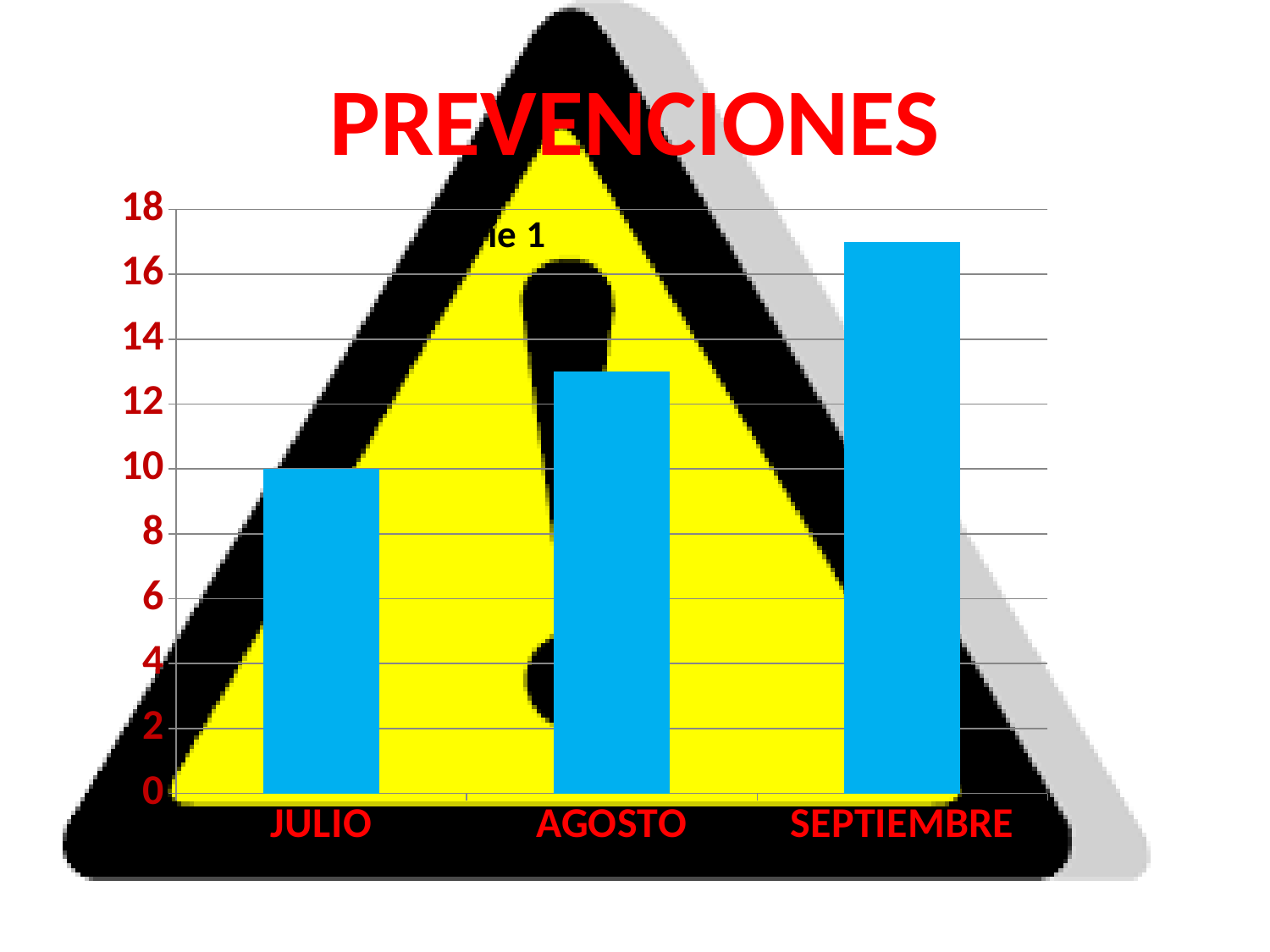
What is the title of the slide? PREVENCIONES Which is larger, the value for AGOSTO or the value for SEPTIEMBRE? SEPTIEMBRE Is the value for AGOSTO greater or less than 14? less What kind of chart is shown on the slide? bar chart Do the values rise or fall from JULIO to SEPTIEMBRE? rise How many months are shown on the x axis? 3 Is the value for SEPTIEMBRE greater or less than 16? greater Which is larger, the value for JULIO or the value for AGOSTO? AGOSTO Is the value for AGOSTO greater or less than 12? greater Which month has the highest value? SEPTIEMBRE What is the value for JULIO? 10 Which month has the lowest value? JULIO